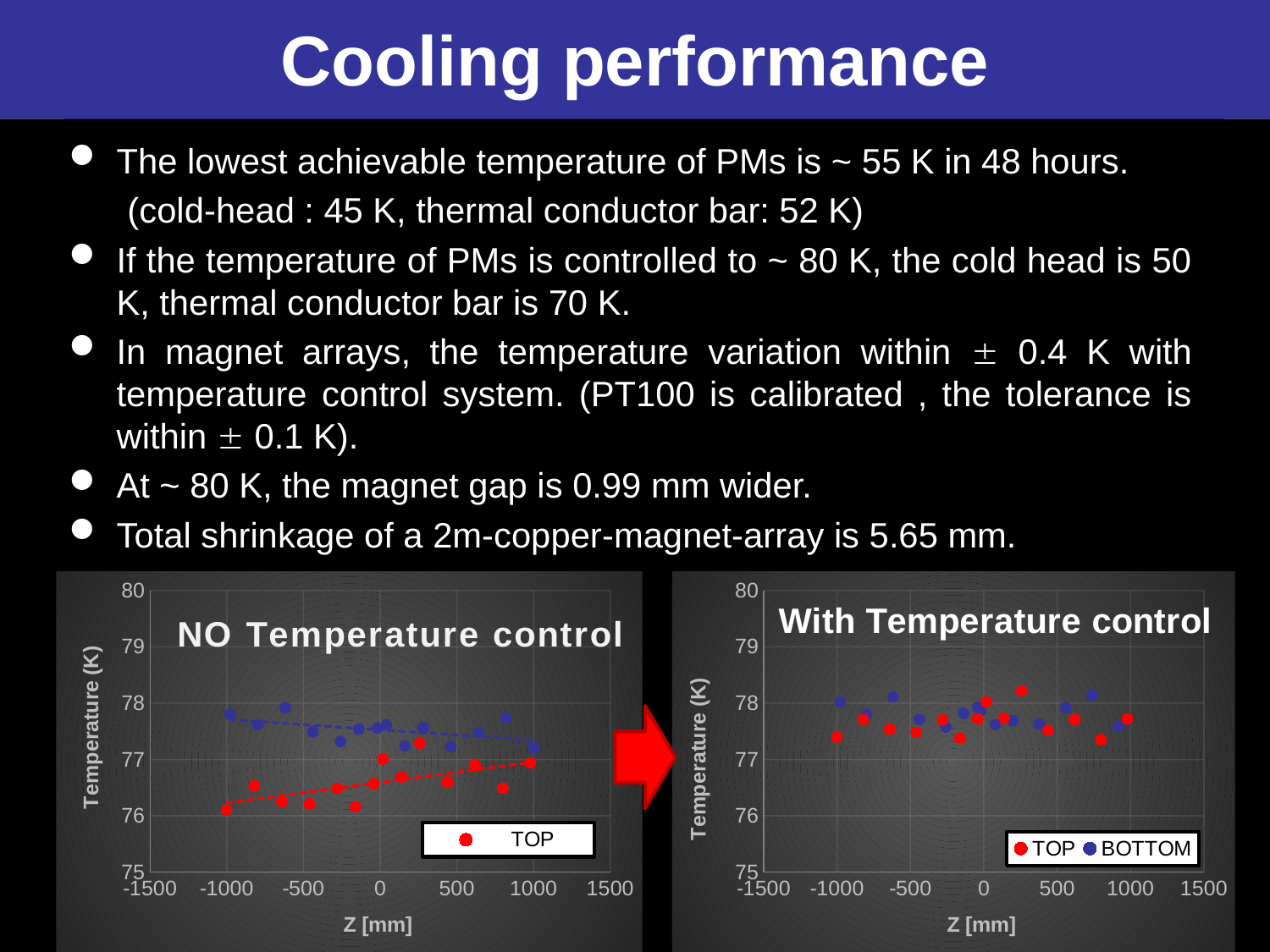
In the left chart, "NO Temperature control", is the blue value at Z = -1000 mm greater or less than 77 K? greater In the right chart, "With Temperature control", are all the plotted TOP and BOTTOM values greater or less than 79 K? less In the left chart, "NO Temperature control", do the red TOP values rise or fall as Z increases from -1000 to 1000 mm? rise What is the x-axis label of the right chart, "With Temperature control"? Z [mm] What is the y-axis label of the left chart, "NO Temperature control"? Temperature (K) What kind of chart is the left chart titled "NO Temperature control"? scatter chart In the left chart, "NO Temperature control", is the TOP value at Z = -1000 mm greater or less than 77 K? less In the left chart, "NO Temperature control", do the blue values rise or fall as Z increases from -1000 to 1000 mm? fall How many series does the legend of the right chart, "With Temperature control", list? 2 How many series does the legend of the left chart, "NO Temperature control", list? 1 In the left chart, "NO Temperature control", which series has the higher temperature at Z = -500 mm, the red TOP series or the blue series? the blue series